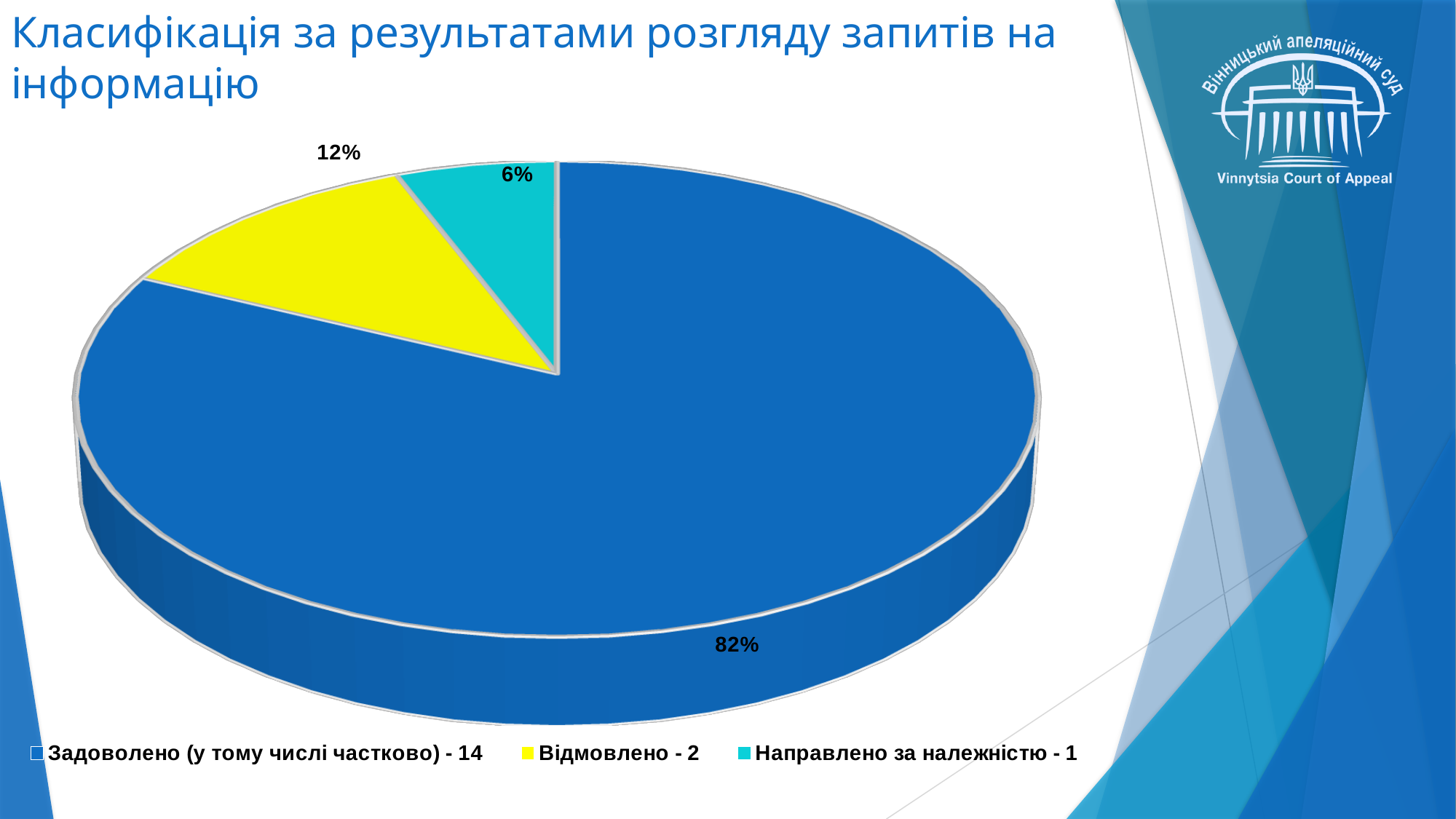
What share of the pie does the slice "Відмовлено - 2" represent? 12% Which category has the smallest slice of the pie? Направлено за належністю - 1 How many entries does the legend list? 3 How many slices does the pie chart have? 3 What share of the pie does the slice "Направлено за належністю - 1" represent? 6% What kind of chart is shown on the slide? Pie chart What colour is the slice for "Відмовлено - 2"? Yellow What share of the pie does the slice "Задоволено (у тому числі частково) - 14" represent? 82% What is the title of the slide containing the pie chart? Класифікація за результатами розгляду запитів на інформацію Which category has the largest slice of the pie? Задоволено (у тому числі частково) - 14 Which slice is larger: "Відмовлено - 2" or "Направлено за належністю - 1"? Відмовлено - 2 What is the difference in percentage points between the "Відмовлено - 2" slice and the "Направлено за належністю - 1" slice? 6%